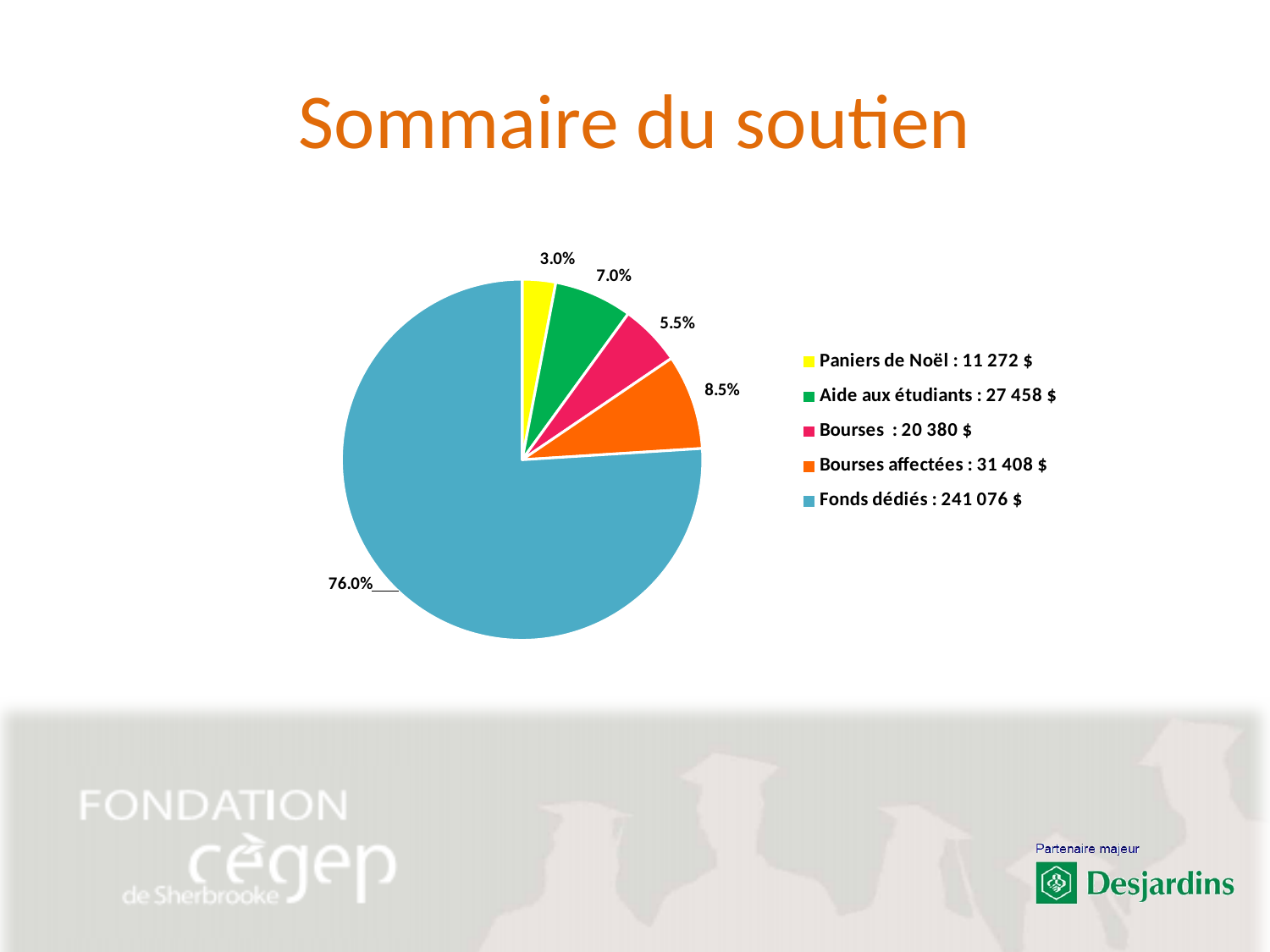
Which category has the smallest slice of the pie? Paniers de Noël What share of the pie does Bourses affectées represent? 8.5% What amount is shown in the legend for Bourses? 20 380 $ What share of the pie does Aide aux étudiants represent? 7.0% What is the title of the slide containing the pie chart? Sommaire du soutien What amount is shown in the legend for Fonds dédiés? 241 076 $ What share of the pie does Fonds dédiés represent? 76.0% Which is larger, the share for Bourses affectées or the share for Aide aux étudiants? Bourses affectées How many slices does the pie chart have? 5 What kind of chart is shown on the slide? pie chart Which category has the largest slice of the pie? Fonds dédiés